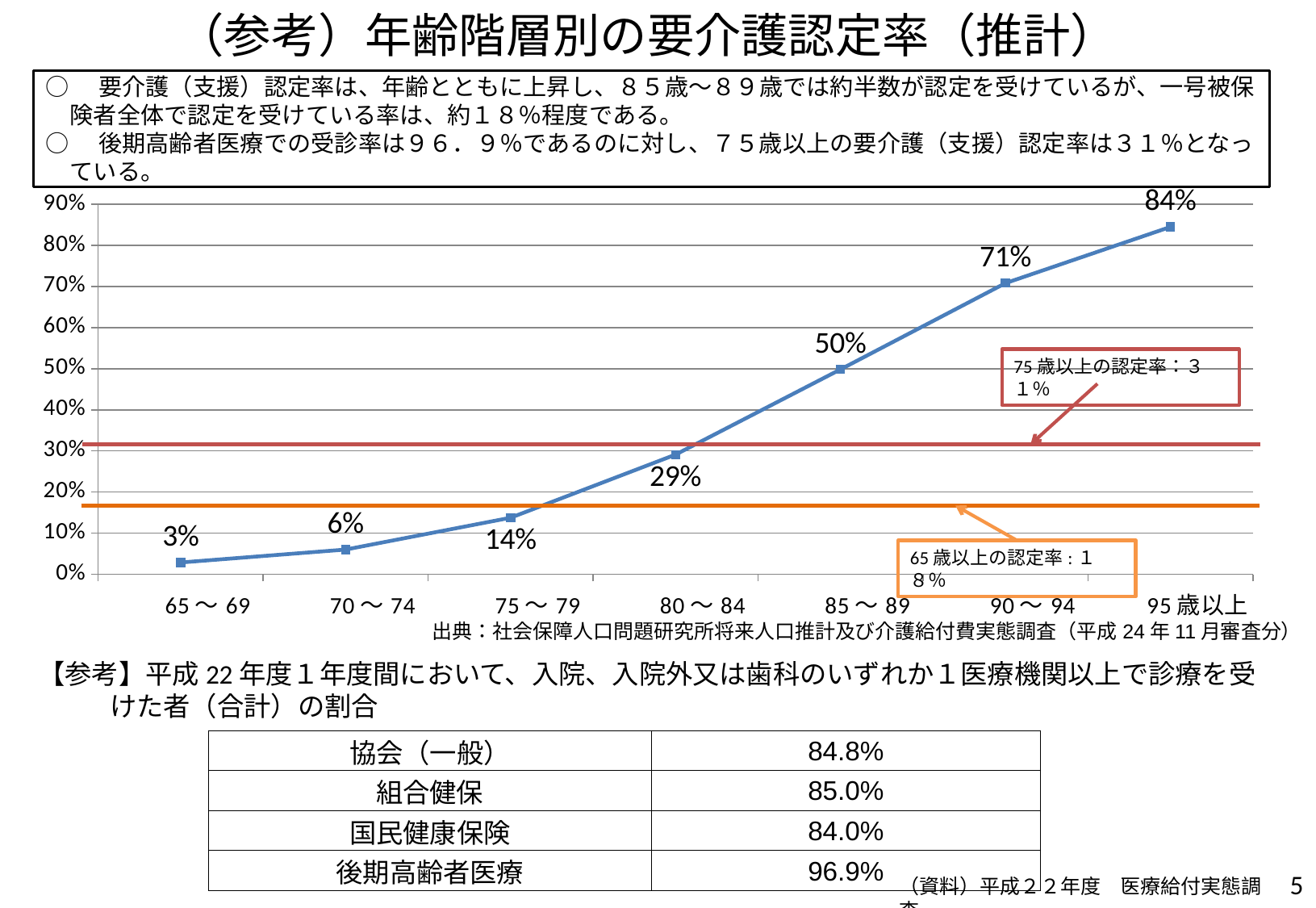
What kind of chart is shown on the slide? line chart What is the certification rate for the 65～69 age group? 3% Which age group has the highest certification rate? 95歳以上 What is the certification rate for the 80～84 age group? 29% Which has a higher certification rate, 75～79 or 70～74? 75～79 Is the value for 85～89 greater or less than 40%? greater What certification rate does the red horizontal reference line for 75歳以上 indicate? 31% Do the certification rates rise or fall as age increases along the x axis? rise Which age group has the lowest certification rate? 65～69 What is the certification rate for the 95歳以上 age group? 84% How many age groups are plotted on the x axis? 7 What is the difference between the certification rates for 90～94 and 85～89? 21%